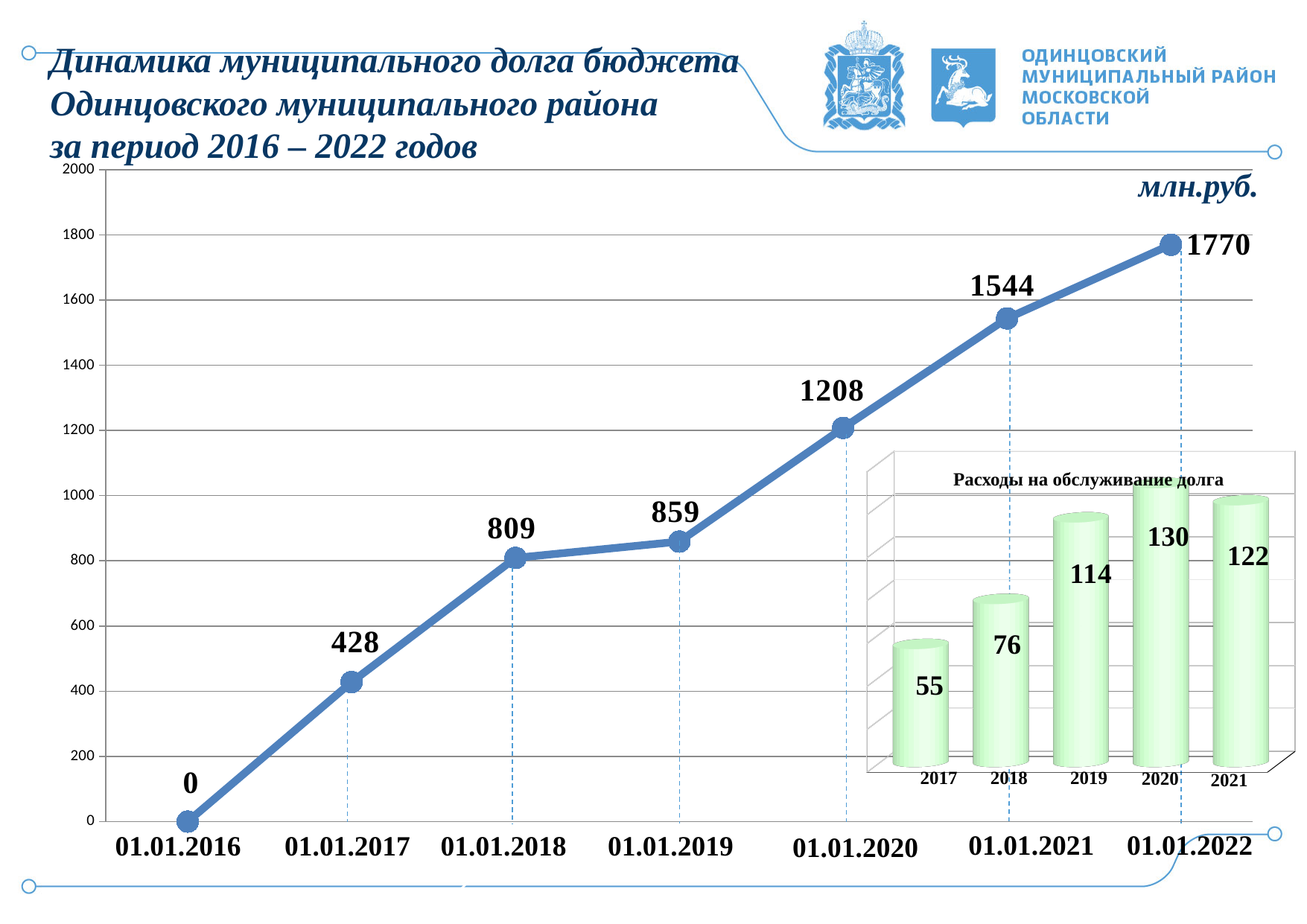
In the inset chart 'Расходы на обслуживание долга', which year has the highest value? 2020 In the main line chart, what is the municipal debt value at 01.01.2017? 428 In the inset chart 'Расходы на обслуживание долга', what is the value for 2019? 114 What type of chart is the main chart showing municipal debt dynamics? line chart In the inset chart 'Расходы на обслуживание долга', what is the difference between the values for 2020 and 2021? 8 In the main line chart, what is the difference between the values at 01.01.2022 and 01.01.2021? 226 In the main line chart, how many data points are plotted? 7 In the inset chart 'Расходы на обслуживание долга', which year has the lowest value? 2017 In the main line chart, do the values rise or fall from 01.01.2016 to 01.01.2022? rise What type of chart is the inset chart 'Расходы на обслуживание долга'? bar chart In the main line chart, which date has the highest municipal debt value? 01.01.2022 In the main line chart, what is the municipal debt value at 01.01.2020? 1208